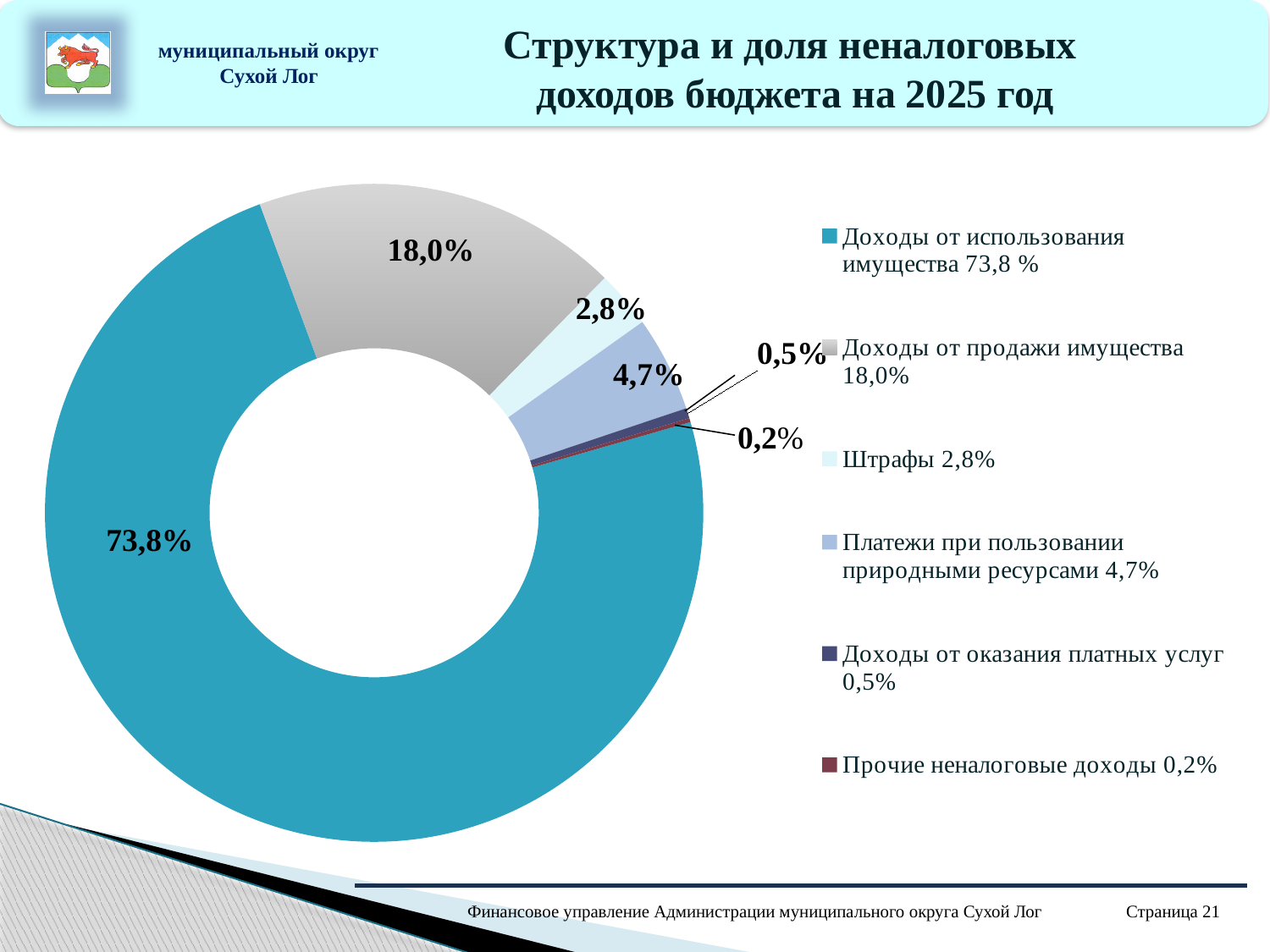
What share is shown for 'Прочие неналоговые доходы'? 0,2% What share is shown for 'Платежи при пользовании природными ресурсами'? 4,7% How many categories does the chart show? 6 By how many percentage points does 'Доходы от использования имущества' exceed 'Доходы от продажи имущества'? 55,8 Which category has the smallest share of non-tax revenue? Прочие неналоговые доходы What share is shown for 'Штрафы'? 2,8% What is the title of the slide? Структура и доля неналоговых доходов бюджета на 2025 год What kind of chart is shown on the slide? doughnut chart What share of non-tax budget revenue comes from 'Доходы от использования имущества'? 73,8% Which is larger: the share for 'Штрафы' or for 'Платежи при пользовании природными ресурсами'? Платежи при пользовании природными ресурсами Which category has the largest share of non-tax revenue? Доходы от использования имущества What share is shown for 'Доходы от продажи имущества'? 18,0%